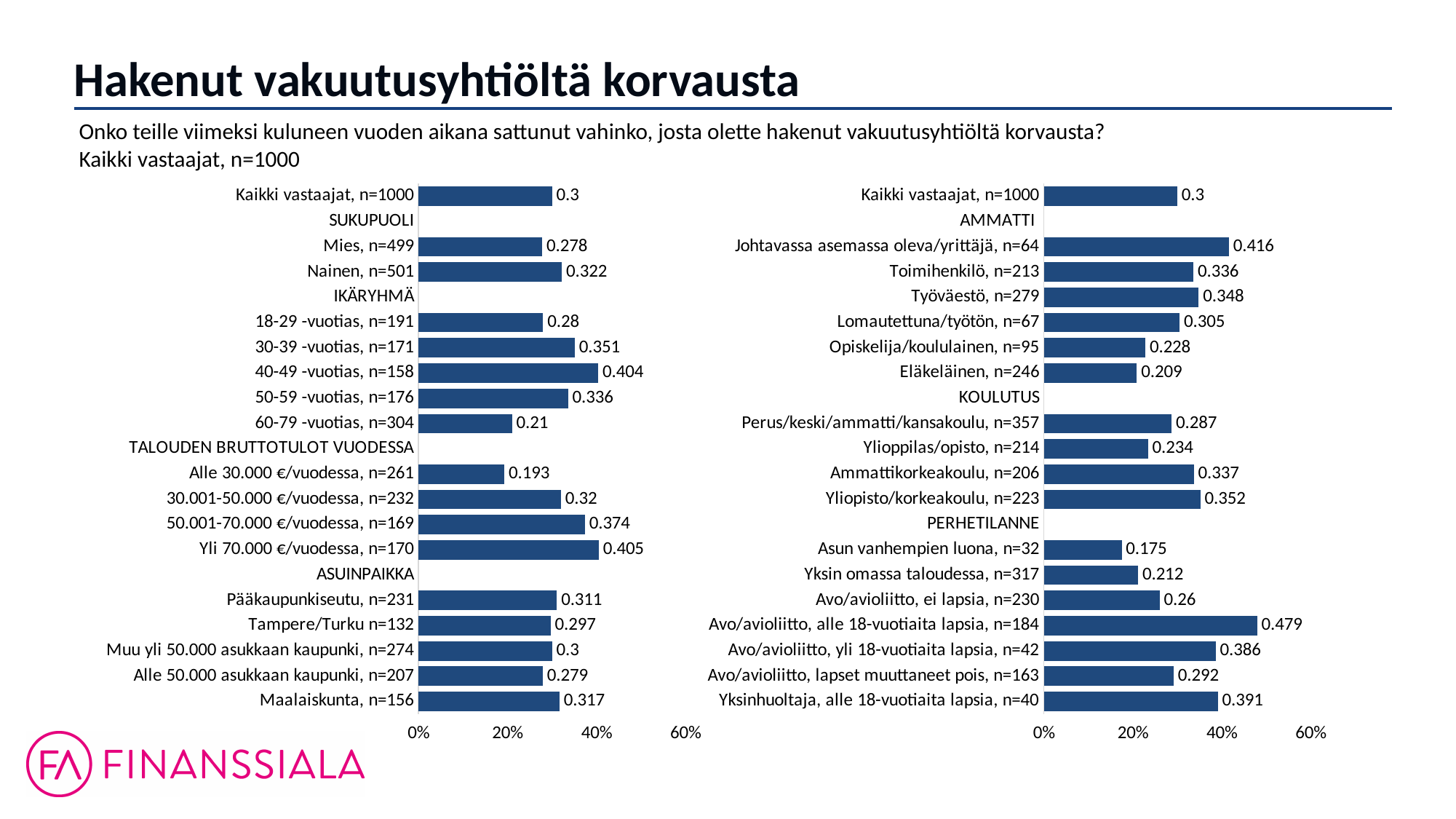
In the right chart, which category has the highest value? Avo/avioliitto, alle 18-vuotiaita lapsia, n=184 In the right chart, which category has the lowest value? Asun vanhempien luona, n=32 In the left chart, which category has the lowest value? Alle 30.000 €/vuodessa, n=261 In the left chart, what is the value for 40-49 -vuotias, n=158? 0.404 In the right chart, what is the value for Yksinhuoltaja, alle 18-vuotiaita lapsia, n=40? 0.391 How many bars are plotted in the right chart? 18 In the left chart, what is the value for Nainen, n=501? 0.322 In the left chart, is the value for 60-79 -vuotias, n=304 greater or less than 40%? less In the right chart, which is larger: the value for Toimihenkilö, n=213 or Työväestö, n=279? Työväestö, n=279 What kind of chart is shown on the left side of the slide? bar chart In the right chart, what is the value for Eläkeläinen, n=246? 0.209 In the left chart, what is the difference between the values for Nainen, n=501 and Mies, n=499? 0.044